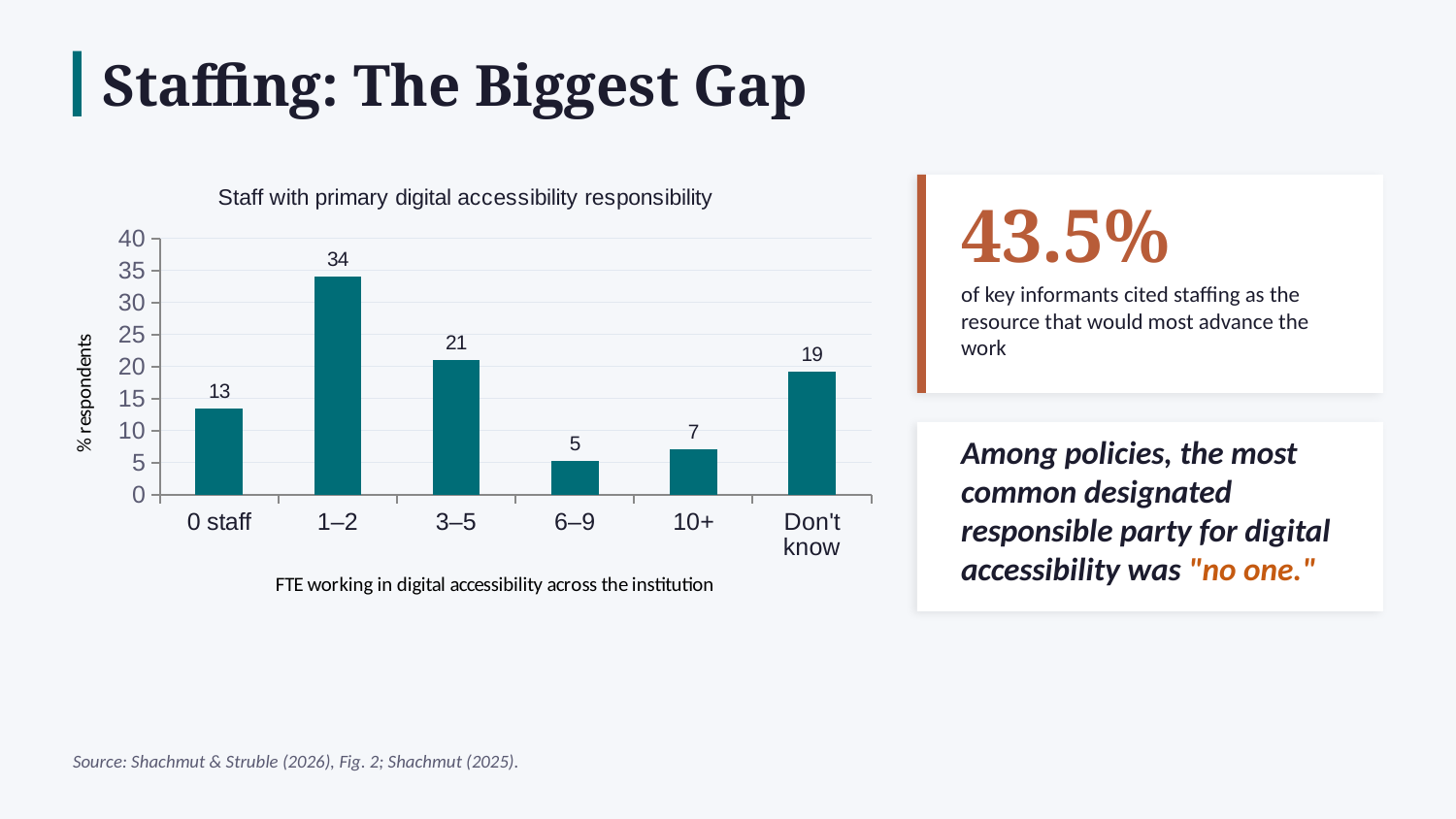
Is the value for 3–5 greater or less than 20? greater Which category has the highest value? 1–2 What is the value for the 1–2 category? 34 What is the value for the Don't know category? 19 What is the value for the 0 staff category? 13 What is the title of the chart? Staff with primary digital accessibility responsibility What is the label of the y axis? % respondents Which is larger, the value for 0 staff or the value for 10+? 0 staff What kind of chart is shown on the slide? bar chart What is the difference between the values for 1–2 and 3–5? 13 Which category has the lowest value? 6–9 How many categories are shown on the x axis? 6